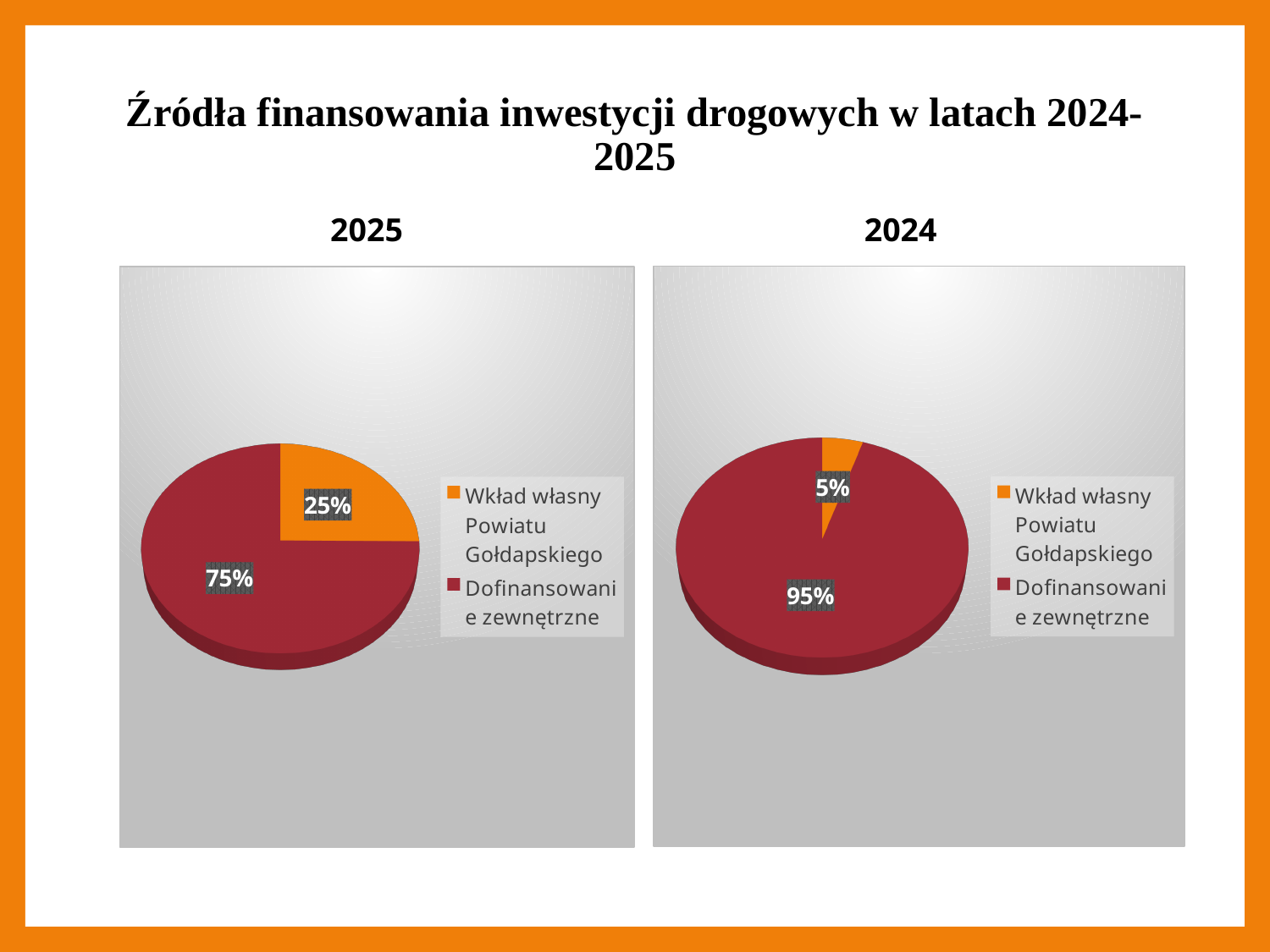
What type of chart is the 2025 chart? Pie chart Is the Wkład własny Powiatu Gołdapskiego share larger in the 2025 chart or the 2024 chart? 2025 In the 2024 chart, what share does Dofinansowanie zewnętrzne have? 95% In the 2025 chart, what colour is the Wkład własny Powiatu Gołdapskiego slice? Orange In the 2025 chart, what share does Wkład własny Powiatu Gołdapskiego have? 25% How many categories does the legend of the 2024 chart list? 2 In the 2025 chart, which category has the smallest slice? Wkład własny Powiatu Gołdapskiego In the 2025 chart, what share does Dofinansowanie zewnętrzne have? 75% In the 2024 chart, which category has the largest slice? Dofinansowanie zewnętrzne In the 2024 chart, what is the difference between the Dofinansowanie zewnętrzne share and the Wkład własny Powiatu Gołdapskiego share? 90% In the 2025 chart, what is the difference between the Dofinansowanie zewnętrzne share and the Wkład własny Powiatu Gołdapskiego share? 50%